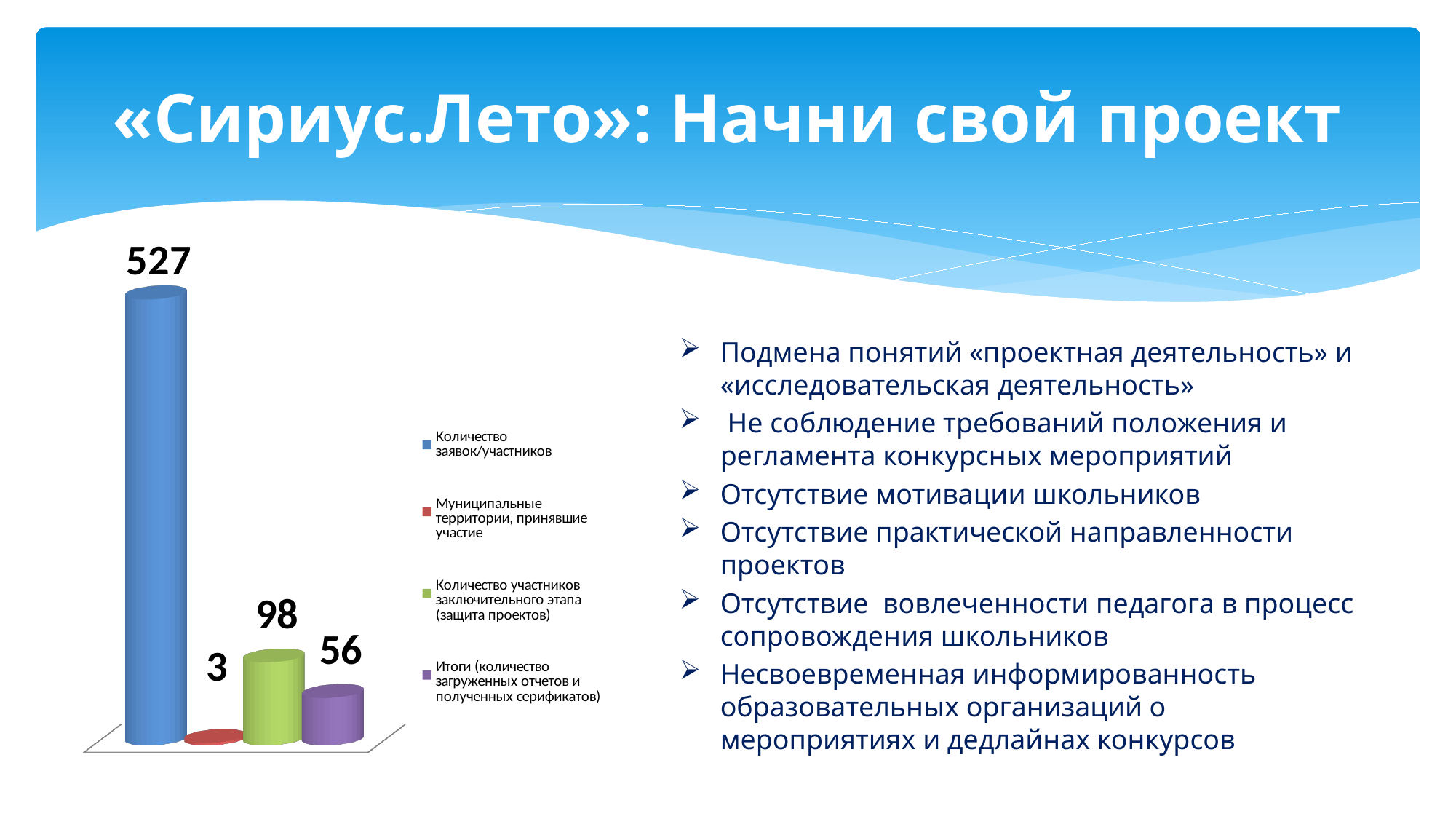
Which is larger: «Количество участников заключительного этапа (защита проектов)» or «Итоги (количество загруженных отчетов и полученных серификатов)»? Количество участников заключительного этапа (защита проектов) Which series has the highest value? Количество заявок/участников What is the value for «Муниципальные территории, принявшие участие»? 3 How many series does the legend list? 4 What is the difference between «Количество заявок/участников» and «Количество участников заключительного этапа (защита проектов)»? 429 What is the value for «Количество заявок/участников»? 527 What kind of chart is shown on the slide? Bar chart What is the value for «Количество участников заключительного этапа (защита проектов)»? 98 What is the difference between «Количество участников заключительного этапа (защита проектов)» and «Итоги (количество загруженных отчетов и полученных серификатов)»? 42 What is the value for «Итоги (количество загруженных отчетов и полученных серификатов)»? 56 What colour is the bar for «Количество заявок/участников»? Blue Which series has the lowest value? Муниципальные территории, принявшие участие